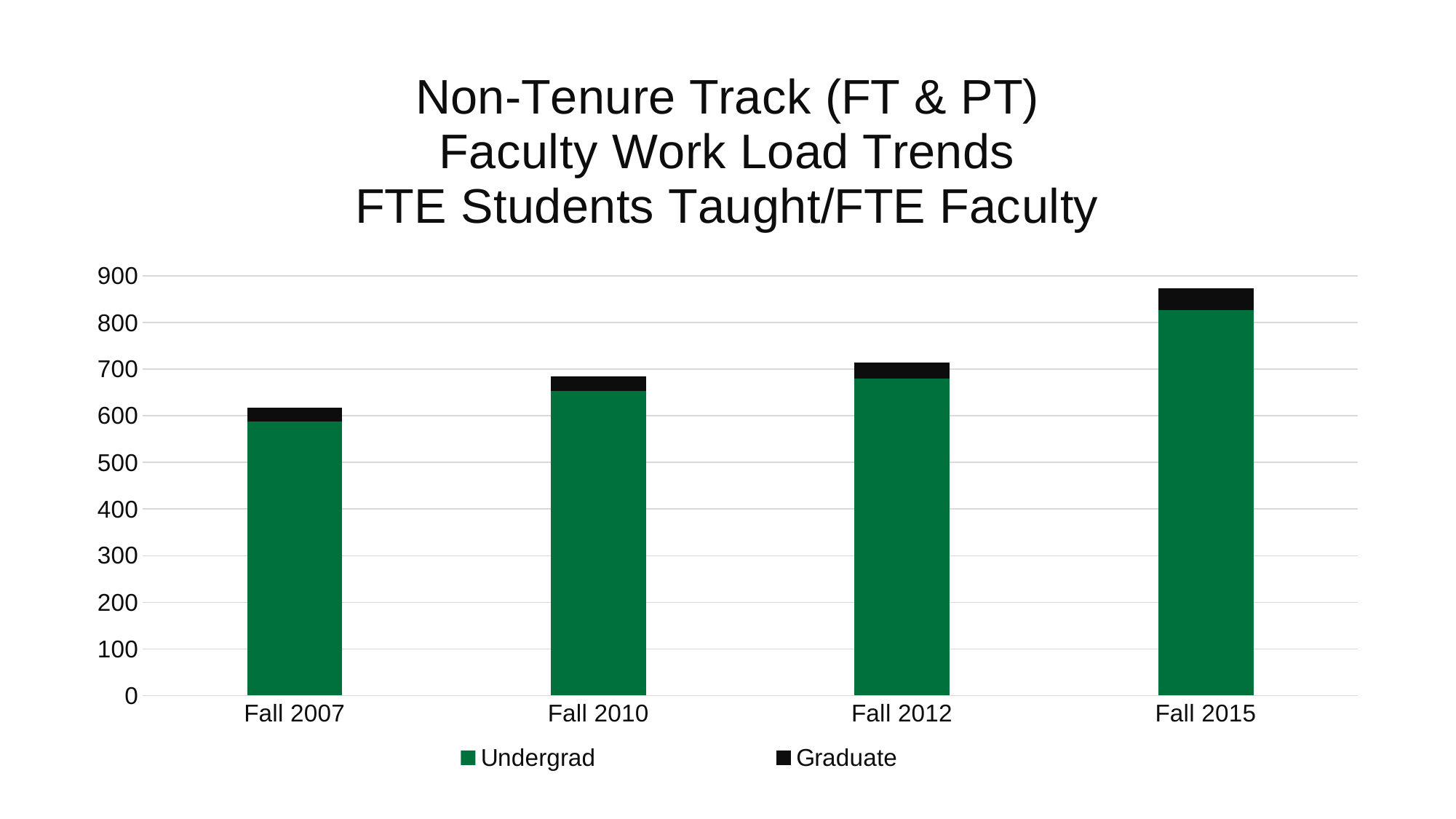
What kind of chart is shown on the slide? Stacked bar chart Is the total bar for Fall 2015 greater or less than 800? greater How many time periods (categories) are shown on the x axis? 4 Which period has the lowest total bar? Fall 2007 Is the Undergrad value for Fall 2015 greater or less than 800? greater Is the total bar for Fall 2007 greater or less than 700? less Do the total bar heights rise or fall from Fall 2007 to Fall 2015? Rise How many series does the legend list? 2 Which period has the highest total bar? Fall 2015 Which colour represents the Graduate series in the legend? Black Which is larger, the Undergrad value for Fall 2015 or for Fall 2007? Fall 2015